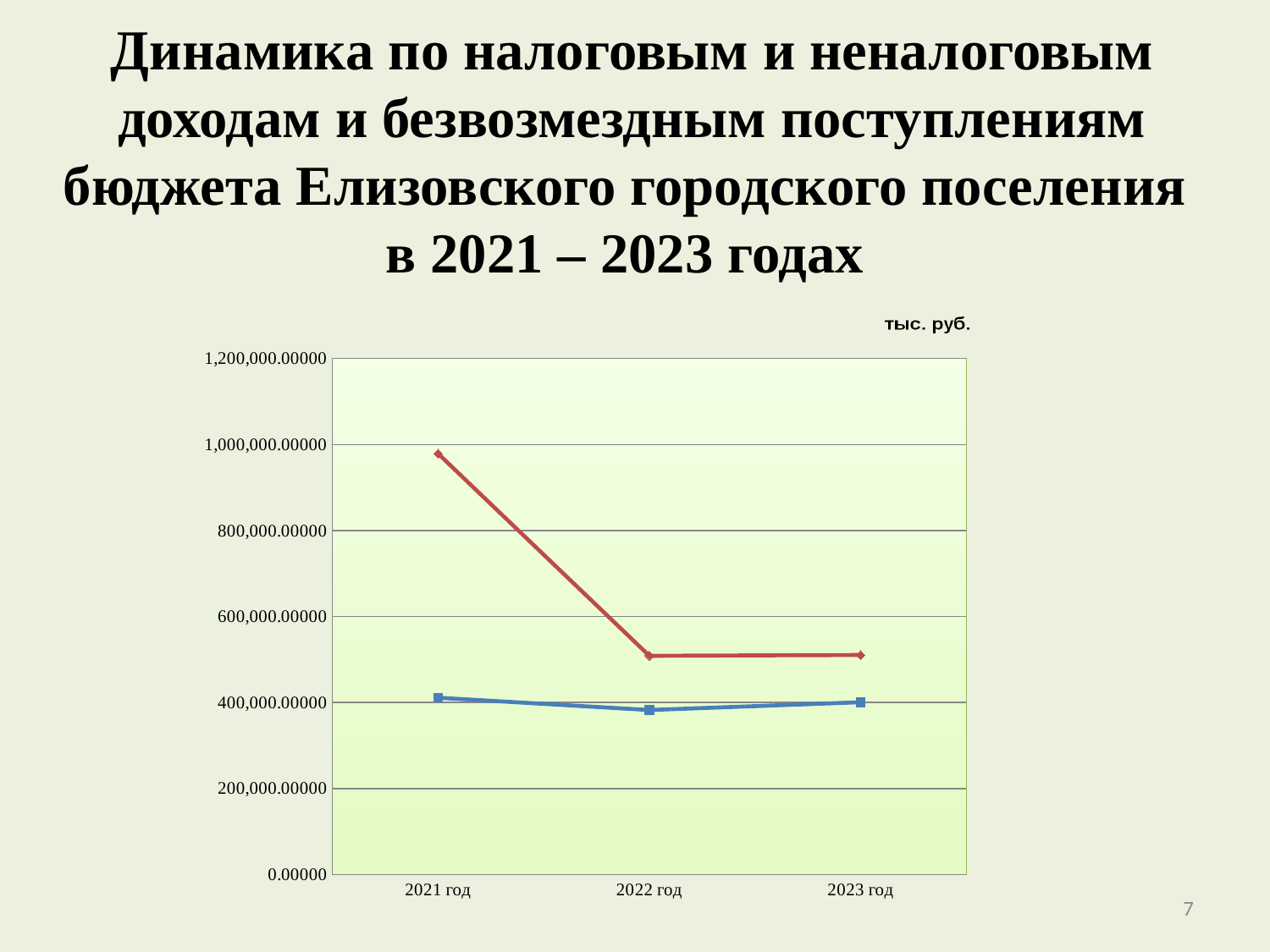
Is the value of the blue line for 2021 год greater or less than 600,000.00000? less How many lines are plotted on the chart? 2 Is the value of the red line for 2021 год greater or less than 800,000.00000? greater Is the value of the red line for 2022 год greater or less than 600,000.00000? less How many years are plotted along the x axis of the chart? 3 What is the highest value shown on the y axis of the chart? 1,200,000.00000 Does the red line rise or fall from 2021 год to 2022 год? fall What unit is indicated above the chart? тыс. руб. What kind of chart is shown on the slide? line chart In which year does the red line reach its highest value? 2021 год Which line has the higher value in 2023 год, the red line or the blue line? the red line